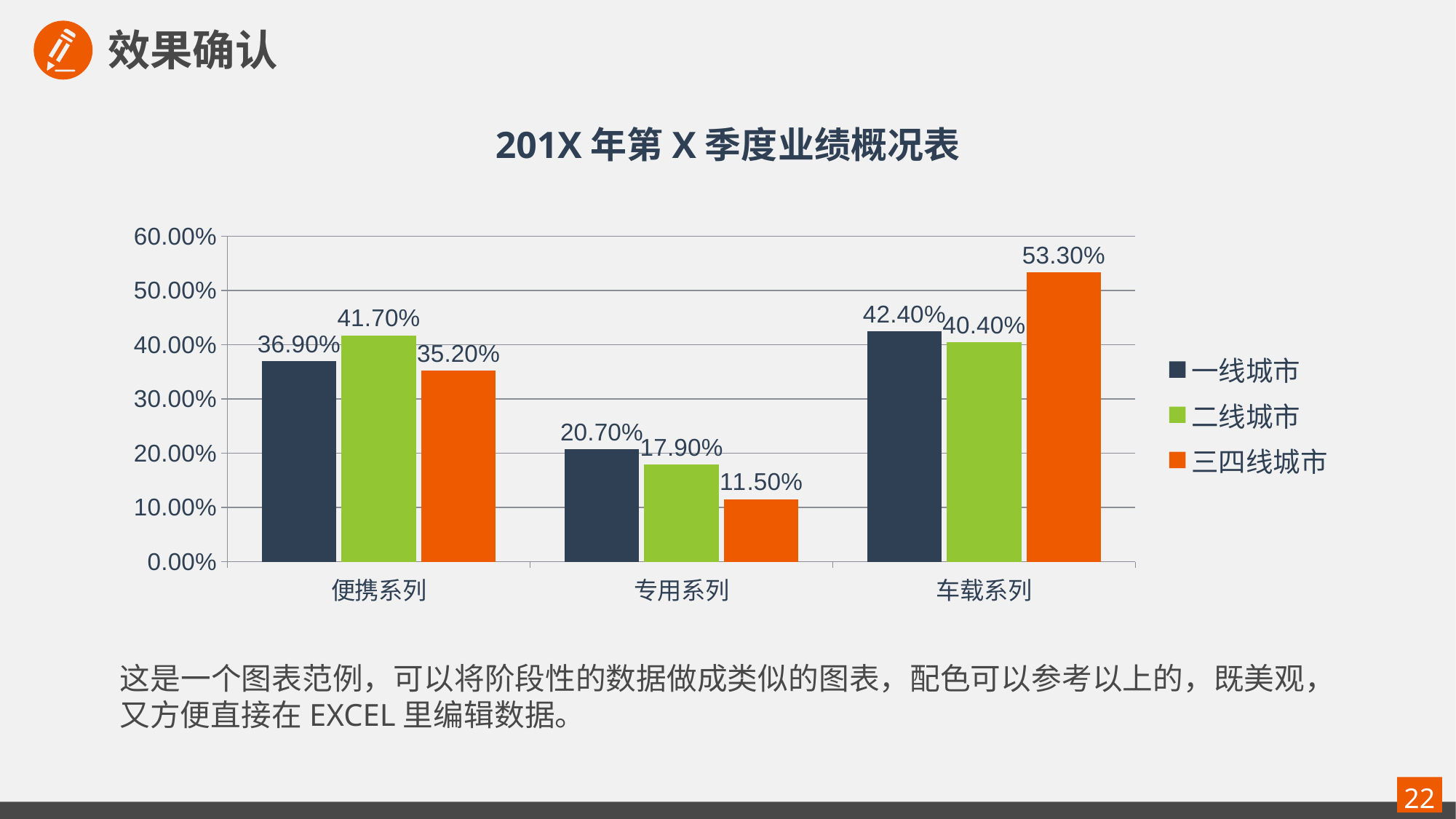
What is the value for 二线城市 in the 专用系列 category? 17.90% What is the value for 三四线城市 in the 车载系列 category? 53.30% What is the difference between the 一线城市 and 三四线城市 values in the 专用系列 category? 9.20% Which colour represents 二线城市 in the legend? Green What is the value for 一线城市 in the 便携系列 category? 36.90% What kind of chart is shown on the slide? Bar chart How many categories are shown on the x axis? 3 What is the title of the chart? 201X 年第 X 季度业绩概况表 Which is larger: the 二线城市 value for 便携系列 or the 二线城市 value for 车载系列? 便携系列 Which series has the highest value in the 车载系列 category? 三四线城市 How many series does the legend list? 3 Which category has the lowest value for 三四线城市? 专用系列